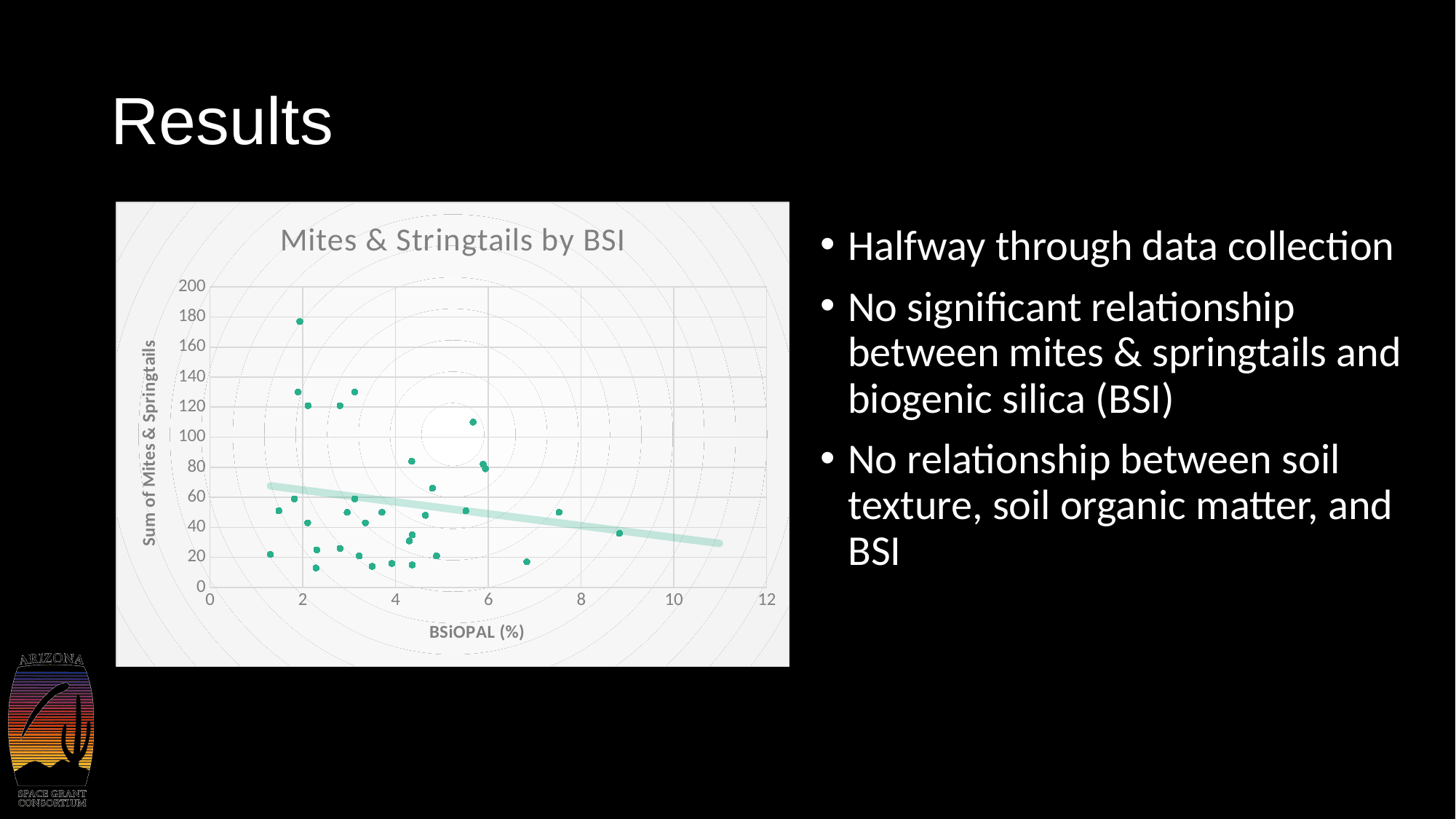
What is the label of the x axis? BSiOPAL (%) What is the title of the chart? Mites & Stringtails by BSI Is the highest plotted value of Sum of Mites & Springtails greater or less than 160? greater Is the Sum of Mites & Springtails for the point near 7.5% BSiOPAL greater or less than 60? less Is the Sum of Mites & Springtails for the point with the largest BSiOPAL (%) value (near 9%) greater or less than 40? less What kind of chart is shown on the slide? scatter plot What is the maximum value shown on the y axis? 200 Does the trend line in the chart rise or fall as BSiOPAL (%) increases? fall